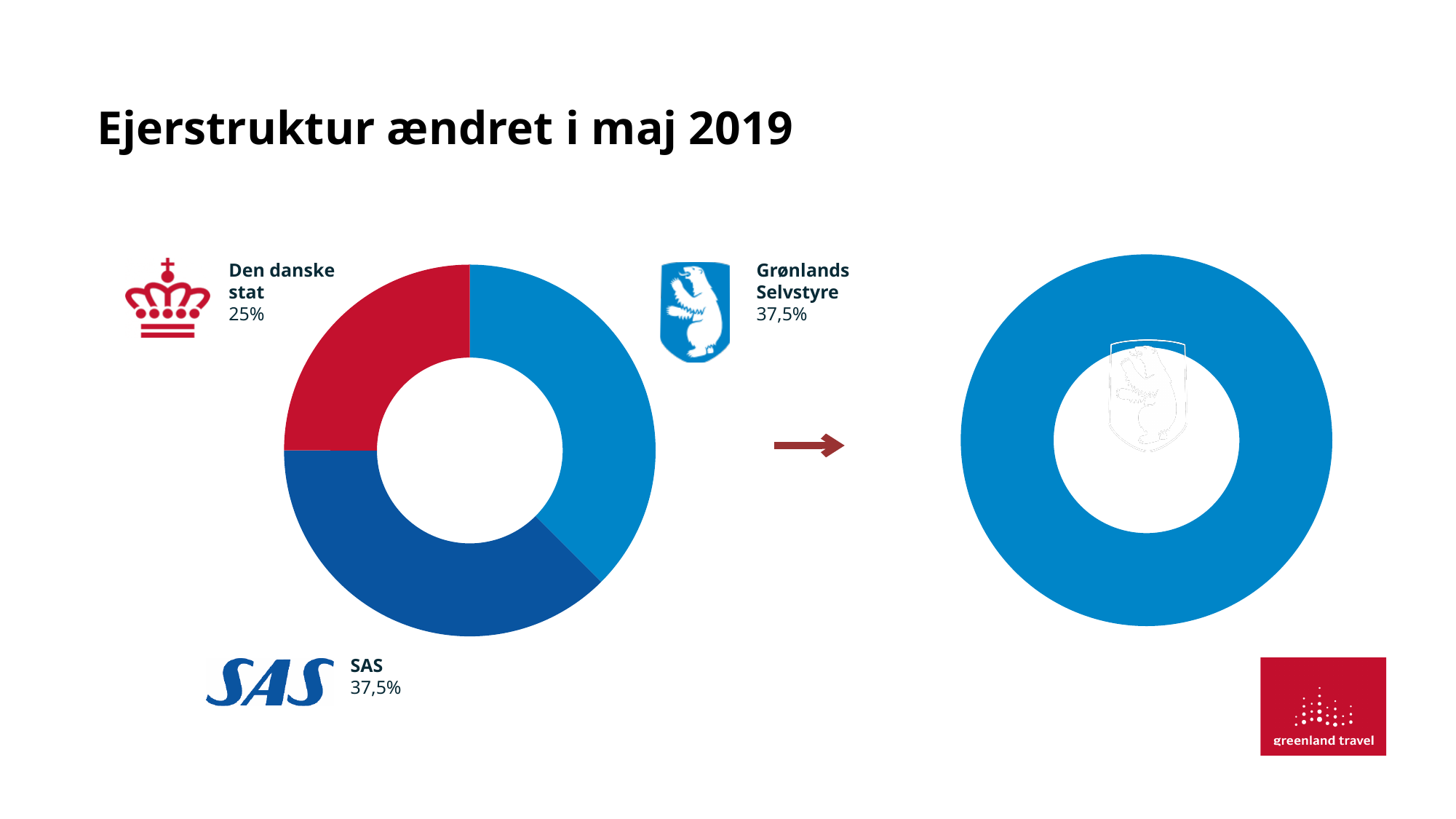
In the left donut chart, do the shares of SAS and Grønlands Selvstyre together add up to more or less than 50%? more In the left donut chart, which is larger: the share of SAS or the share of Den danske stat? SAS In the left donut chart, what is the difference between the share of Grønlands Selvstyre and the share of Den danske stat? 12,5% In the left donut chart, which owner has the smallest share? Den danske stat In the left donut chart, what share does Den danske stat hold? 25% What is the title of the slide containing the ownership charts? Ejerstruktur ændret i maj 2019 In the left donut chart, how many owners (slices) are shown? 3 In the left donut chart, what share does Grønlands Selvstyre hold? 37,5% In the left donut chart, what colour is the slice for Den danske stat? Red What kind of chart is shown on the left of the slide? Donut (pie) chart In the left donut chart, what share does SAS hold? 37,5%